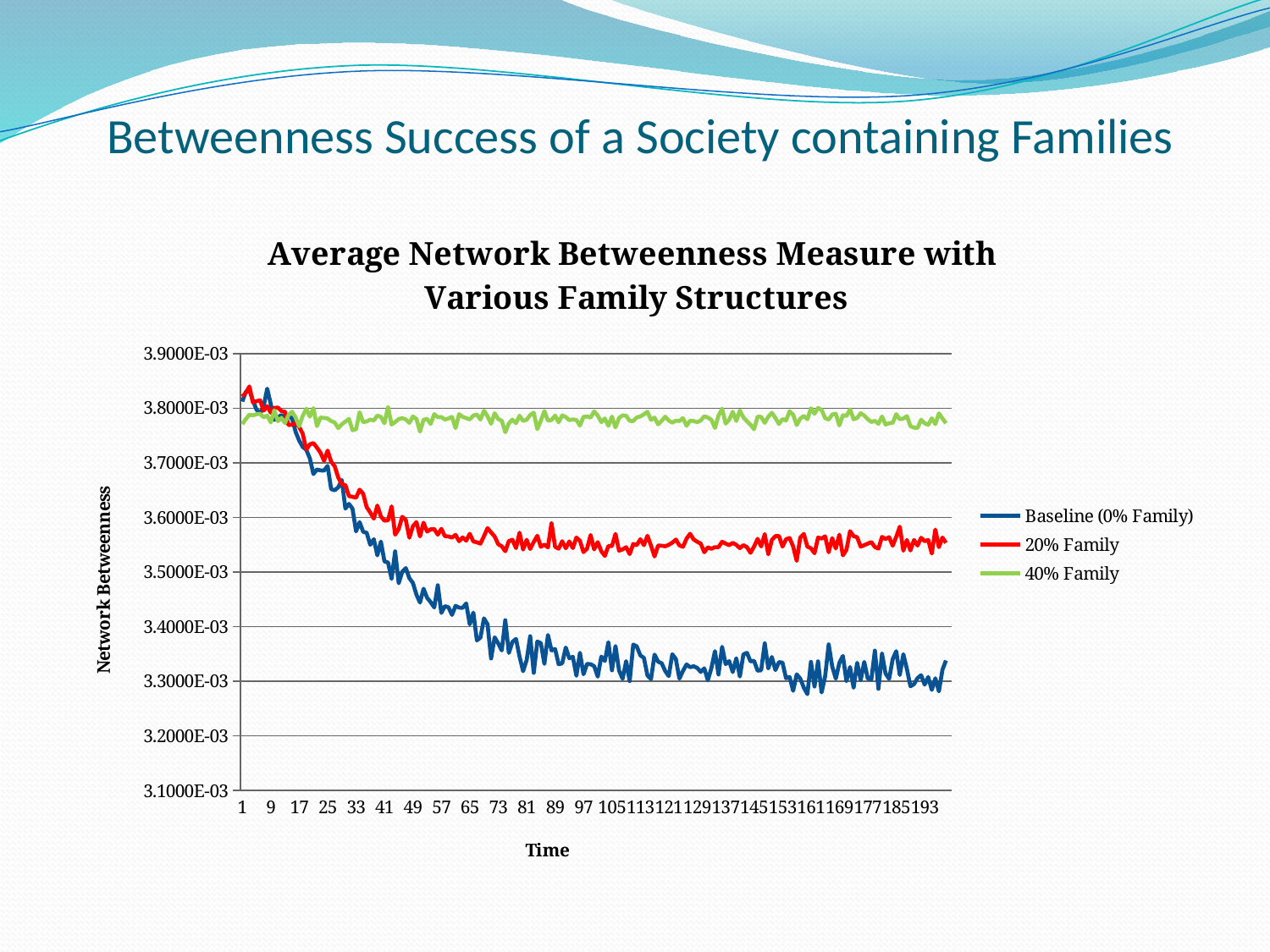
Which series has the lowest values at the end of the time axis? Baseline (0% Family) Does the 20% Family series rise or fall over time? Fall Is the value of the 40% Family series at time 105 greater or less than 3.7000E-03? greater What is the title of the chart? Average Network Betweenness Measure with Various Family Structures What kind of chart is shown on the slide? Line chart Does the Baseline (0% Family) series rise or fall over time? Fall Is the value of the 20% Family series at time 145 greater or less than 3.6000E-03? less Which series has the highest values at the end of the time axis? 40% Family Is the value of the Baseline (0% Family) series at time 193 greater or less than 3.4000E-03? less What is the label of the x axis? Time At time 150, which series is higher: 20% Family or Baseline (0% Family)? 20% Family How many series does the legend list? 3